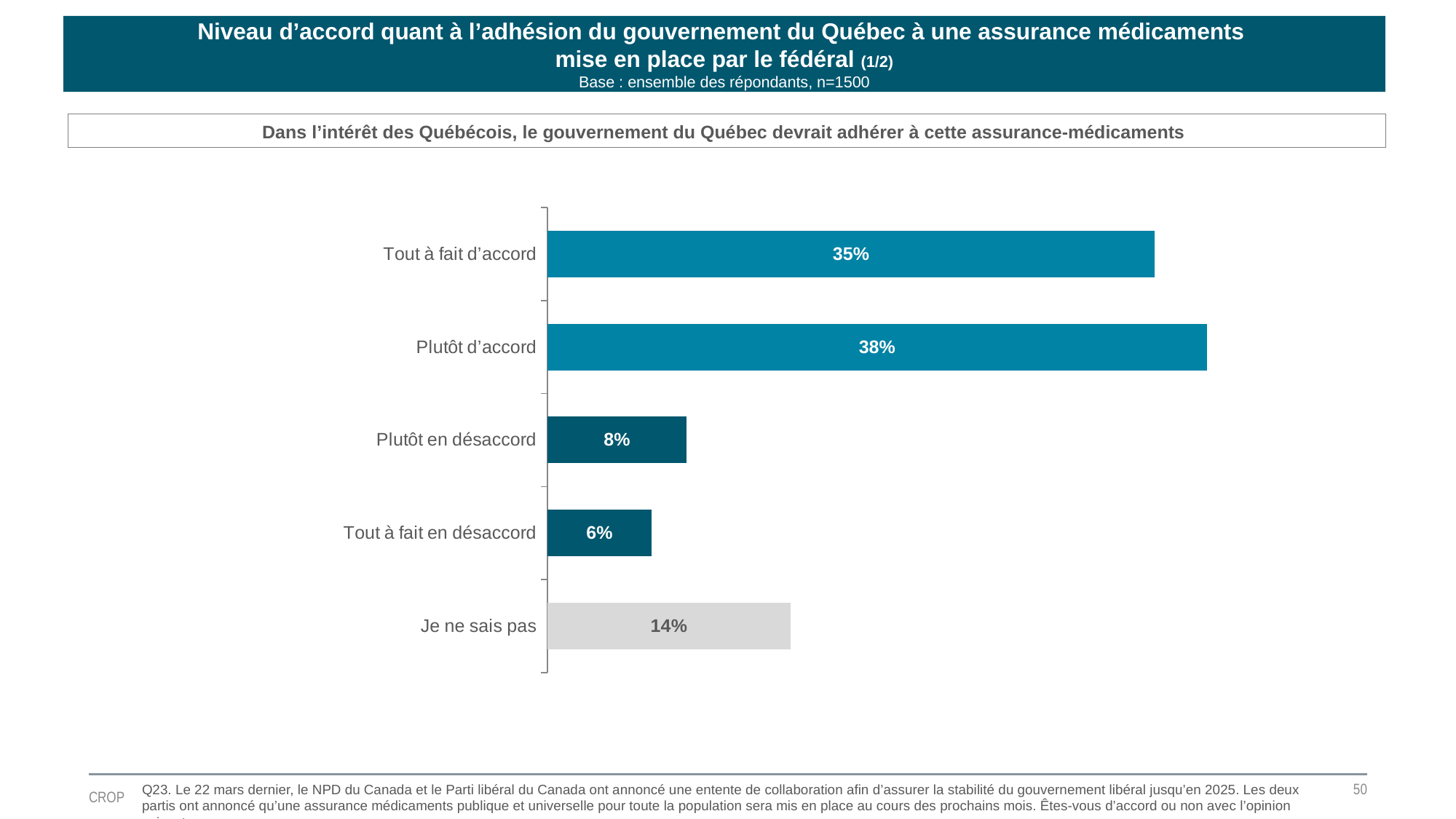
What kind of chart is shown on the slide? Bar chart Which is larger, "Je ne sais pas" or "Plutôt en désaccord"? Je ne sais pas What is the value for "Tout à fait en désaccord"? 6% What is the combined value of "Tout à fait d'accord" and "Plutôt d'accord"? 73% What is the difference between "Plutôt d'accord" and "Tout à fait d'accord"? 3% Which category has the lowest value? Tout à fait en désaccord What is the value for "Je ne sais pas"? 14% How many categories are shown in the chart? 5 What is the value for "Plutôt d'accord"? 38% What is the value for "Plutôt en désaccord"? 8% What is the value for "Tout à fait d'accord"? 35% Which category has the highest value? Plutôt d'accord